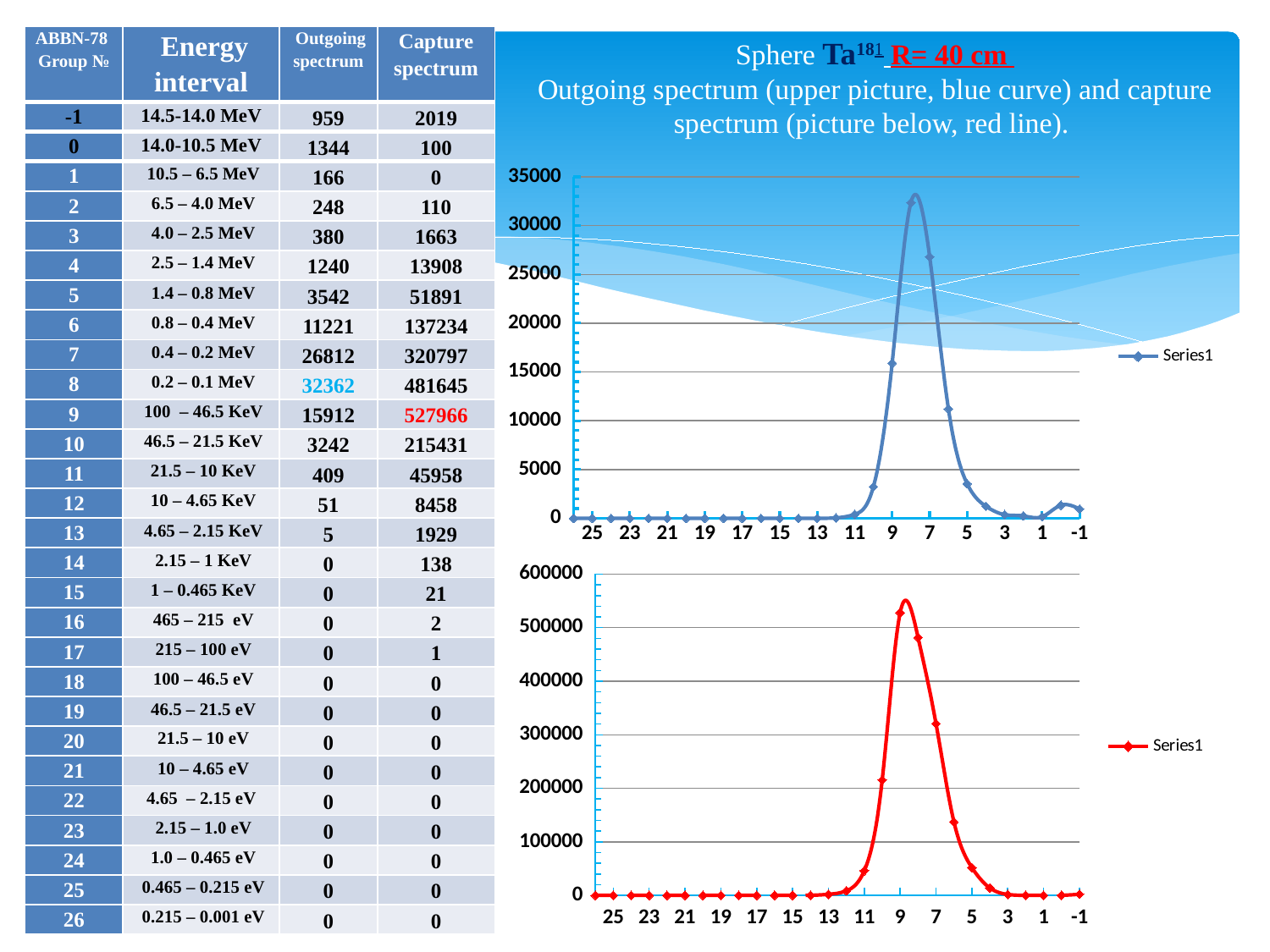
In the upper chart, is the value at group 8 greater or less than 30000? greater In the lower chart, which has the larger value: group 10 or group 8? group 8 In the upper chart, at which x-axis group number does the curve reach its highest value? 8 What is the name of the series shown in the legend of the upper chart? Series1 How many series does the legend of the lower chart list? 1 In the upper chart, do the values rise or fall moving along the x axis from group 8 to group 1? fall What kind of chart is the upper chart on the slide? line chart In the lower chart, is the value at group 6 greater or less than 100000? greater In the lower chart, is the value at group 9 greater or less than 500000? greater In the lower chart, at which x-axis group number does the curve reach its highest value? 9 In the upper chart, which has the larger value: group 7 or group 9? group 7